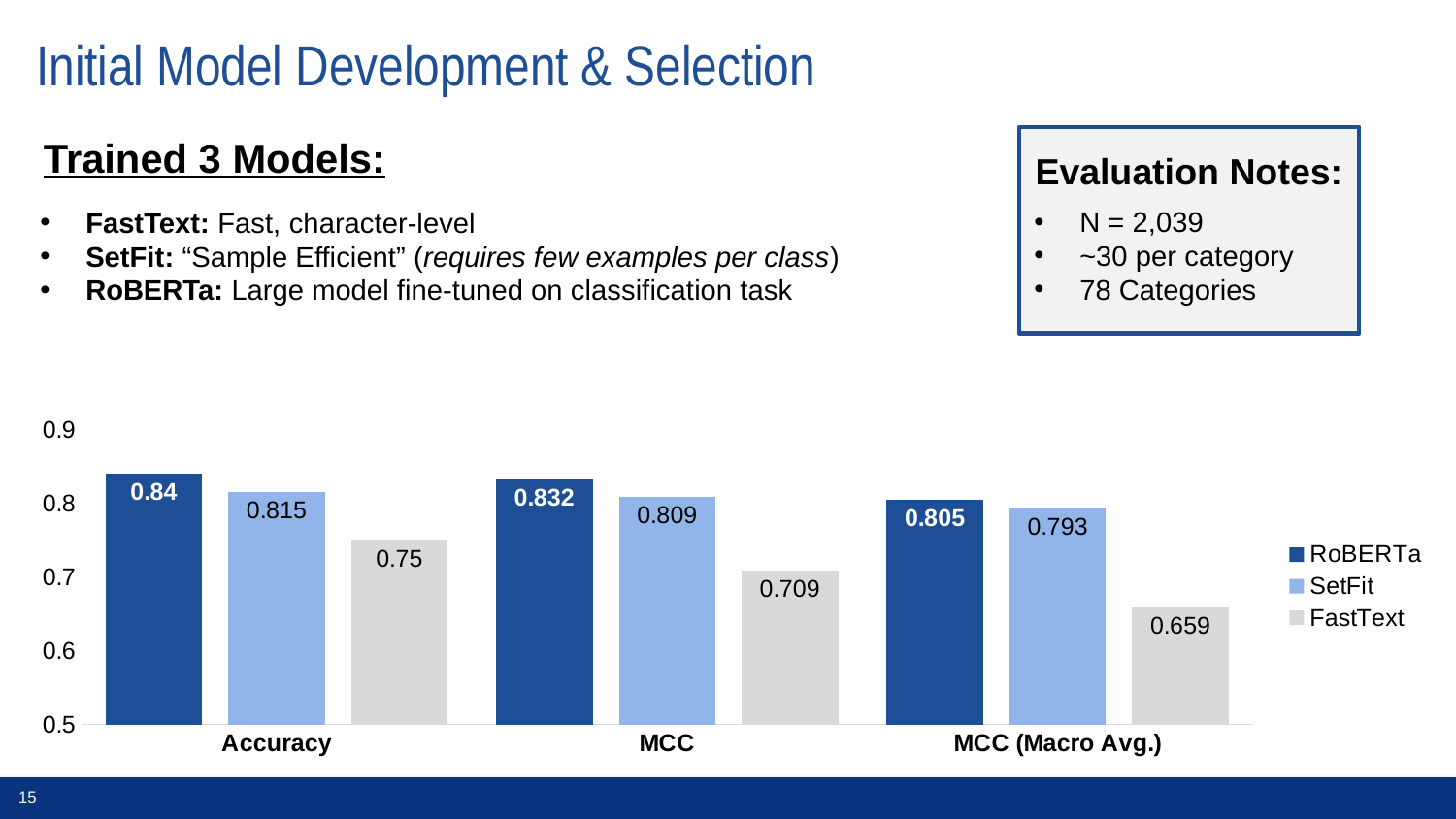
What is the difference between the MCC (Macro Avg.) values of SetFit and FastText? 0.134 What is the MCC value for FastText? 0.709 How many series does the legend list? 3 Which model has the lowest Accuracy value? FastText Is the MCC (Macro Avg.) value for FastText greater or less than 0.7? less What is the Accuracy value for RoBERTa? 0.84 What is the MCC (Macro Avg.) value for SetFit? 0.793 Which model has the highest MCC (Macro Avg.) value? RoBERTa How many categories are shown on the x axis? 3 What kind of chart is shown on the slide? bar chart Which is larger, the MCC value for SetFit or the MCC value for FastText? SetFit What is the difference between the Accuracy values of RoBERTa and FastText? 0.09